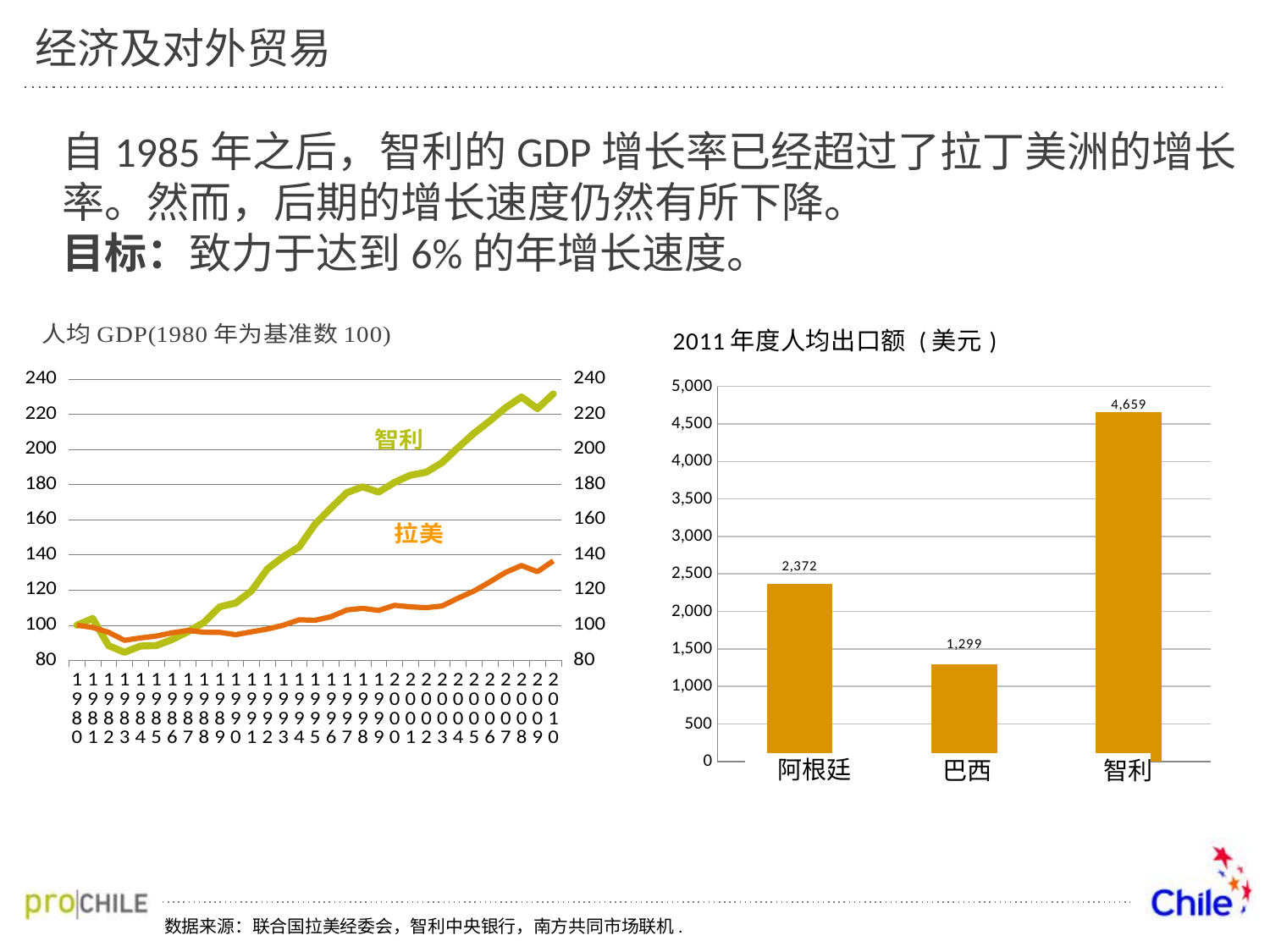
What kind of chart is the one titled 人均 GDP(1980 年为基准数 100)? line chart In the chart titled 2011 年度人均出口额（美元）, what is the value for 阿根廷? 2,372 What kind of chart is the one titled 2011 年度人均出口额（美元）? bar chart In the chart titled 2011 年度人均出口额（美元）, what is the value for 巴西? 1,299 In the chart titled 人均 GDP(1980 年为基准数 100), which series is higher in 2010, 智利 or 拉美? 智利 In the chart titled 人均 GDP(1980 年为基准数 100), how many series are plotted? 2 In the chart titled 2011 年度人均出口额（美元）, which country has the highest value? 智利 In the chart titled 人均 GDP(1980 年为基准数 100), is the value for 智利 in 2010 greater or less than 220? greater In the chart titled 2011 年度人均出口额（美元）, how many countries are shown? 3 In the chart titled 2011 年度人均出口额（美元）, which country has the lowest value? 巴西 In the chart titled 2011 年度人均出口额（美元）, what is the value for 智利? 4,659 In the chart titled 2011 年度人均出口额（美元）, what is the difference between the values for 智利 and 阿根廷? 2,287